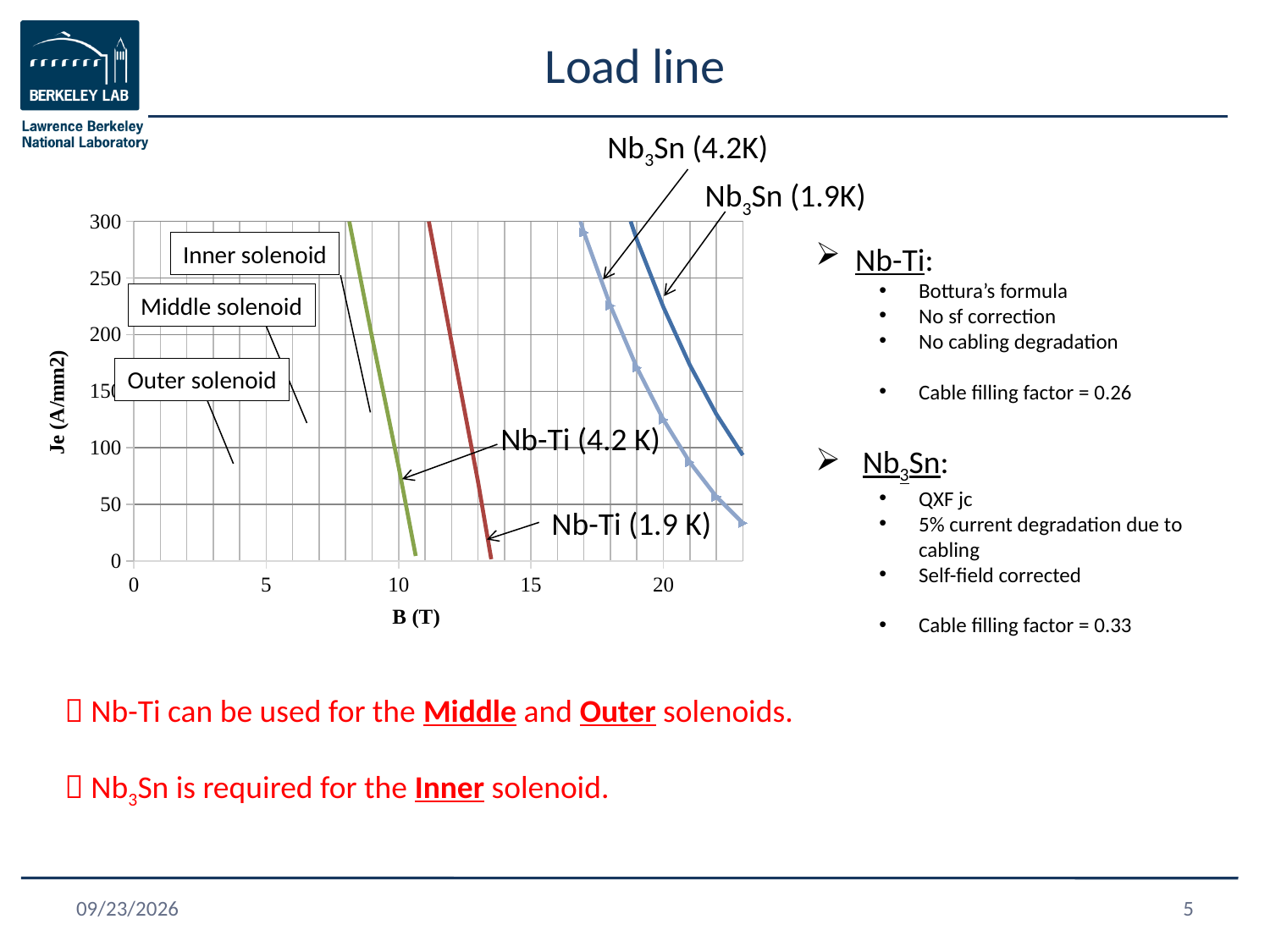
Do the Je values of the Nb-Ti (4.2 K) curve rise or fall as B increases? fall What is the label of the x axis of the chart? B (T) What is the highest tick value shown on the Je axis? 300 Is the Je value of the Nb3Sn (1.9K) curve at B = 20 T greater or less than 100? greater Is the value of B at which the Nb-Ti (1.9 K) curve reaches Je = 0 greater or less than 15? less Do the Je values of the Nb3Sn (1.9K) curve rise or fall as B increases? fall At B = 20 T, which curve has the higher Je: Nb3Sn (1.9K) or Nb3Sn (4.2K)? Nb3Sn (1.9K) What kind of chart is shown on the slide? line chart How many superconductor curves are labeled on the chart (Nb-Ti and Nb3Sn at each temperature)? 4 What is the label of the y axis of the chart? Je (A/mm2) Which labeled curve reaches Je = 0 at the lowest value of B? Nb-Ti (4.2 K)